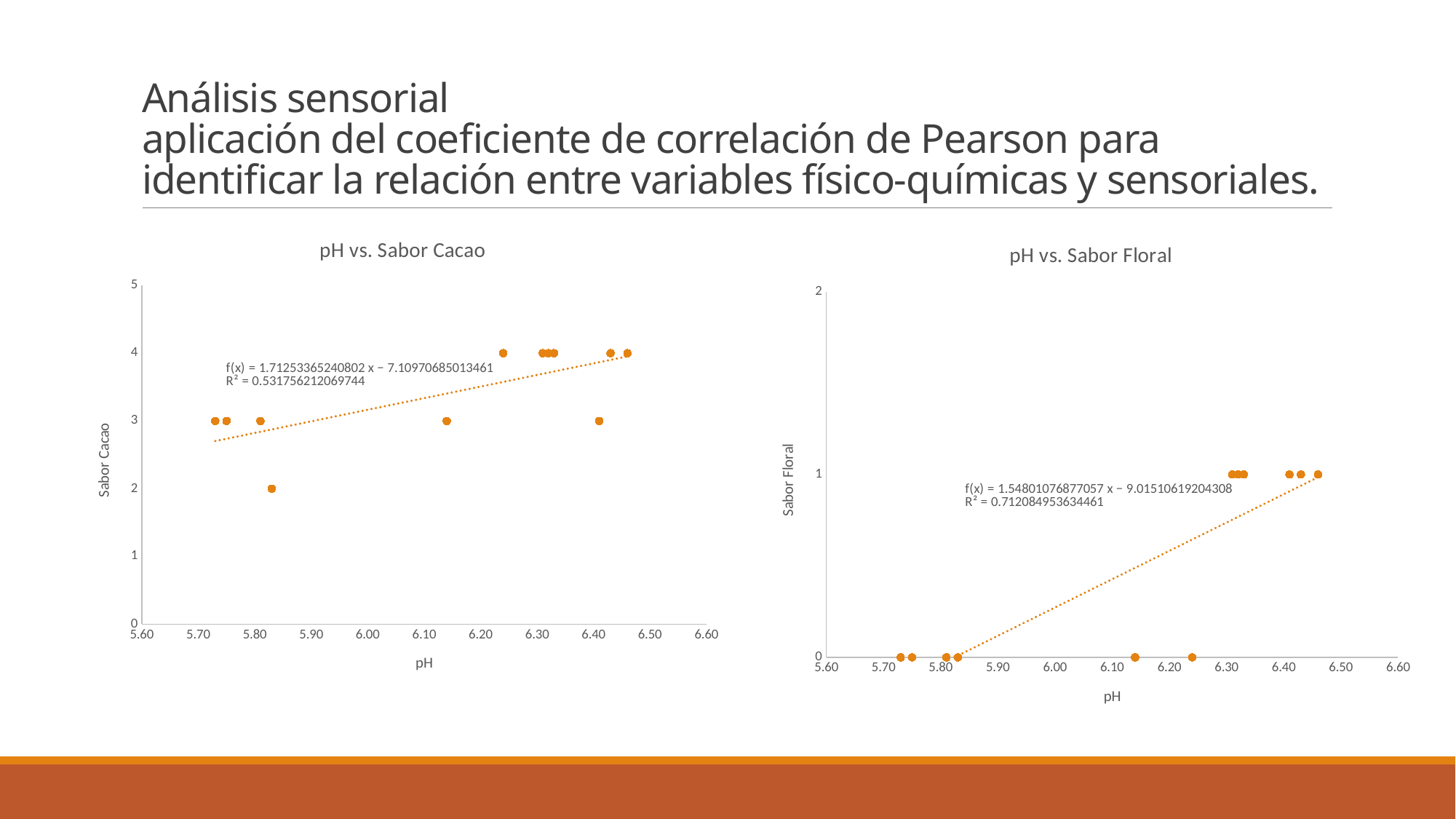
In the "pH vs. Sabor Floral" chart, what is the highest Sabor Floral value plotted? 1 In the "pH vs. Sabor Cacao" chart, does the trendline rise or fall as pH increases? Rises In the "pH vs. Sabor Floral" chart, what is the trendline equation shown? f(x) = 1.54801076877057 x − 9.01510619204308 In the "pH vs. Sabor Cacao" chart, what is the trendline equation shown? f(x) = 1.71253365240802 x − 7.10970685013461 In the "pH vs. Sabor Cacao" chart, what is the highest Sabor Cacao value plotted? 4 In the "pH vs. Sabor Cacao" chart, what is the lowest Sabor Cacao value plotted? 2 Which chart has the higher R² value, "pH vs. Sabor Cacao" or "pH vs. Sabor Floral"? pH vs. Sabor Floral What is the title of the y axis in the chart on the right? Sabor Floral What kind of chart is "pH vs. Sabor Cacao"? Scatter chart In the "pH vs. Sabor Floral" chart, what is the R² value shown for the trendline? 0.712084953634461 In the "pH vs. Sabor Cacao" chart, what is the R² value shown for the trendline? 0.531756212069744 How many charts are shown on the slide? 2